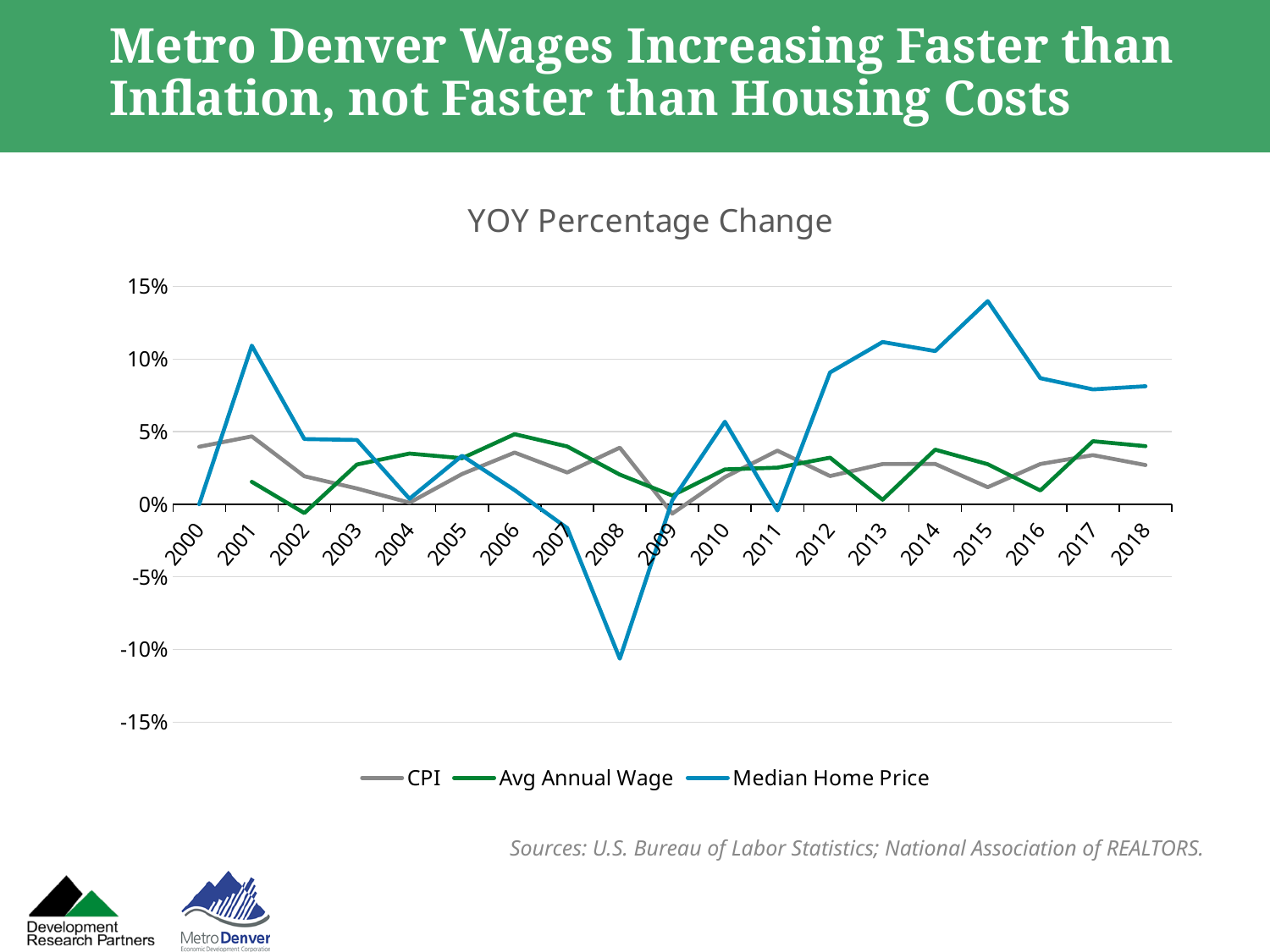
How many years are plotted along the x axis? 19 Is the value for Median Home Price in 2015 greater or less than 10%? greater What kind of chart is shown on the slide? Line chart Which is larger in 2015, the Median Home Price value or the Avg Annual Wage value? Median Home Price In which year does the Median Home Price series reach its highest value? 2015 Is the value for Median Home Price in 2008 greater or less than -5%? less Does the Median Home Price series rise or fall from 2015 to 2016? Fall What is the title of the chart? YOY Percentage Change Which is larger in 2008, the CPI value or the Median Home Price value? CPI In which year does the Median Home Price series reach its lowest value? 2008 How many series does the legend list? 3 Is the value for Avg Annual Wage in 2013 greater or less than 5%? less